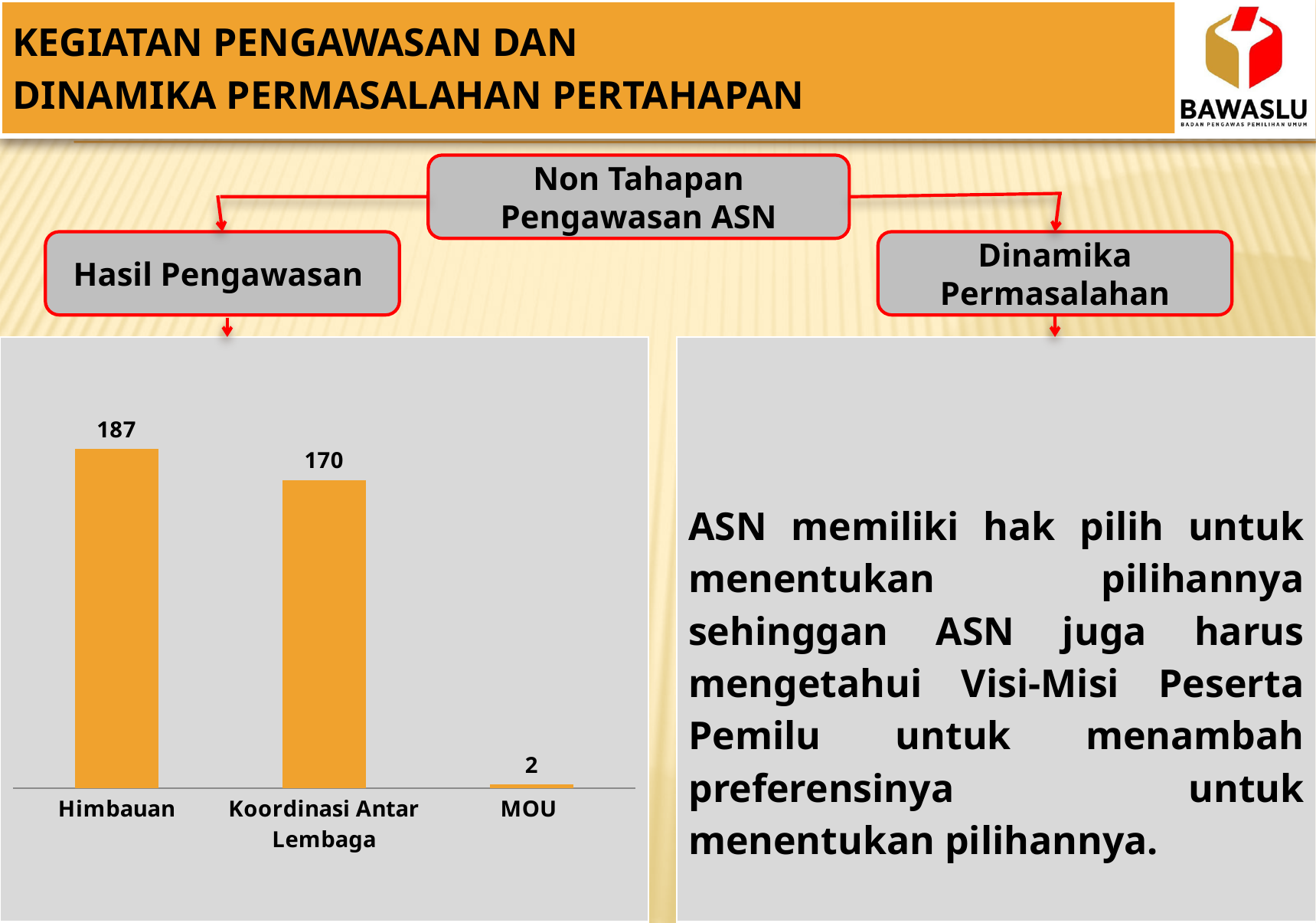
Which category has the highest value? Himbauan What colour are the bars in the chart? Orange What is the difference between the values for Himbauan and Koordinasi Antar Lembaga? 17 What is the value for Himbauan? 187 What is the difference between the values for Koordinasi Antar Lembaga and MOU? 168 Which is larger, the value for Himbauan or the value for MOU? Himbauan Which category has the lowest value? MOU What is the value for MOU? 2 What is the value for Koordinasi Antar Lembaga? 170 How many categories are shown in the chart? 3 Do the values rise or fall from left to right across the categories? Fall What kind of chart is shown on the slide? Bar chart